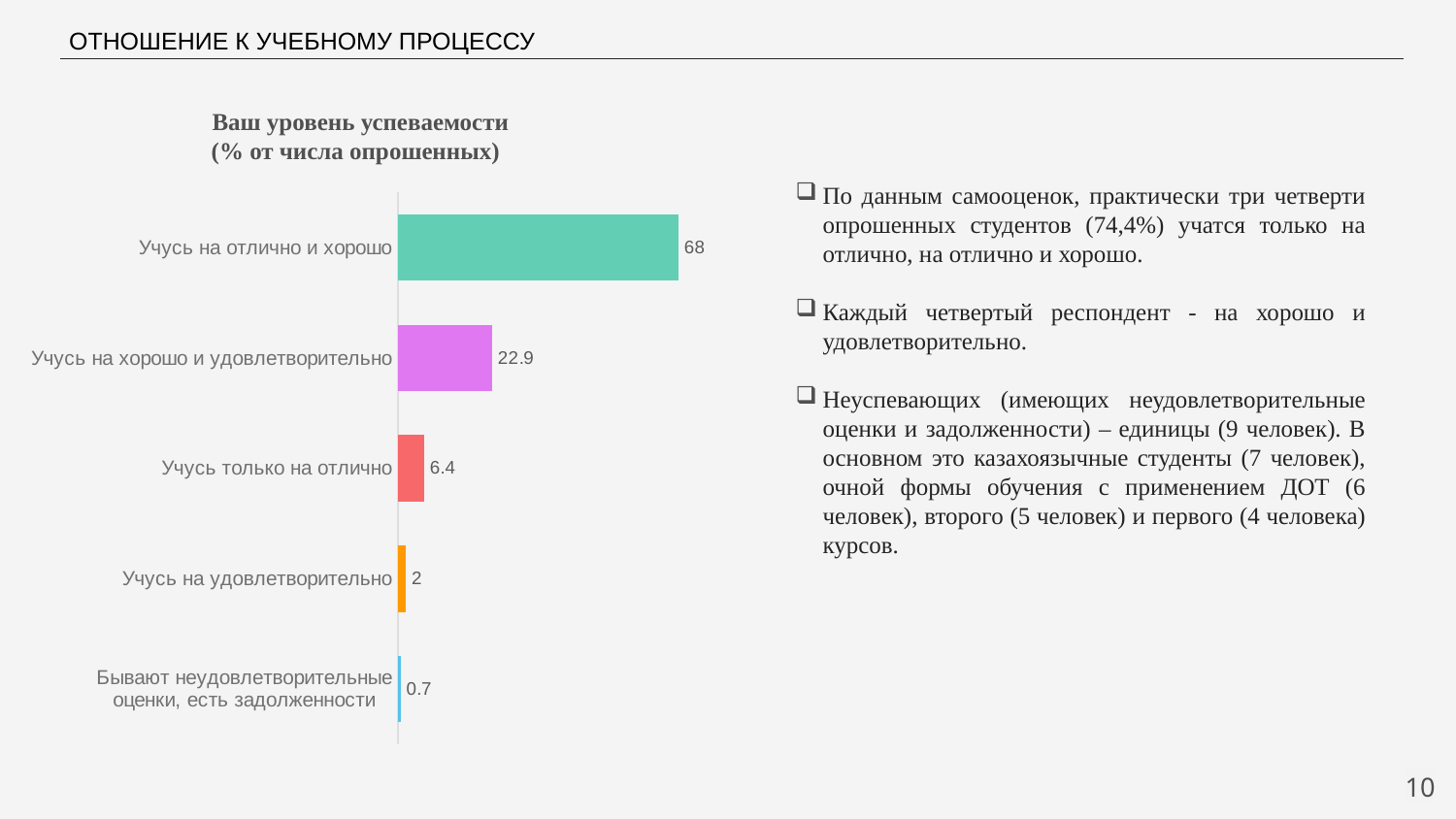
What is the value for "Учусь только на отлично"? 6.4 Which is larger: the value for "Учусь только на отлично" or "Учусь на удовлетворительно"? Учусь только на отлично What is the title of the chart? Ваш уровень успеваемости (% от числа опрошенных) What is the value for "Бывают неудовлетворительные оценки, есть задолженности"? 0.7 Which category has the lowest value? Бывают неудовлетворительные оценки, есть задолженности What is the value for "Учусь на хорошо и удовлетворительно"? 22.9 How many categories are shown in the chart? 5 What is the value for "Учусь на отлично и хорошо"? 68 What is the difference between the values for "Учусь на отлично и хорошо" and "Учусь на хорошо и удовлетворительно"? 45.1 What kind of chart is shown on the slide? Bar chart Which category has the highest value? Учусь на отлично и хорошо What colour is the bar for "Учусь на хорошо и удовлетворительно"? Purple